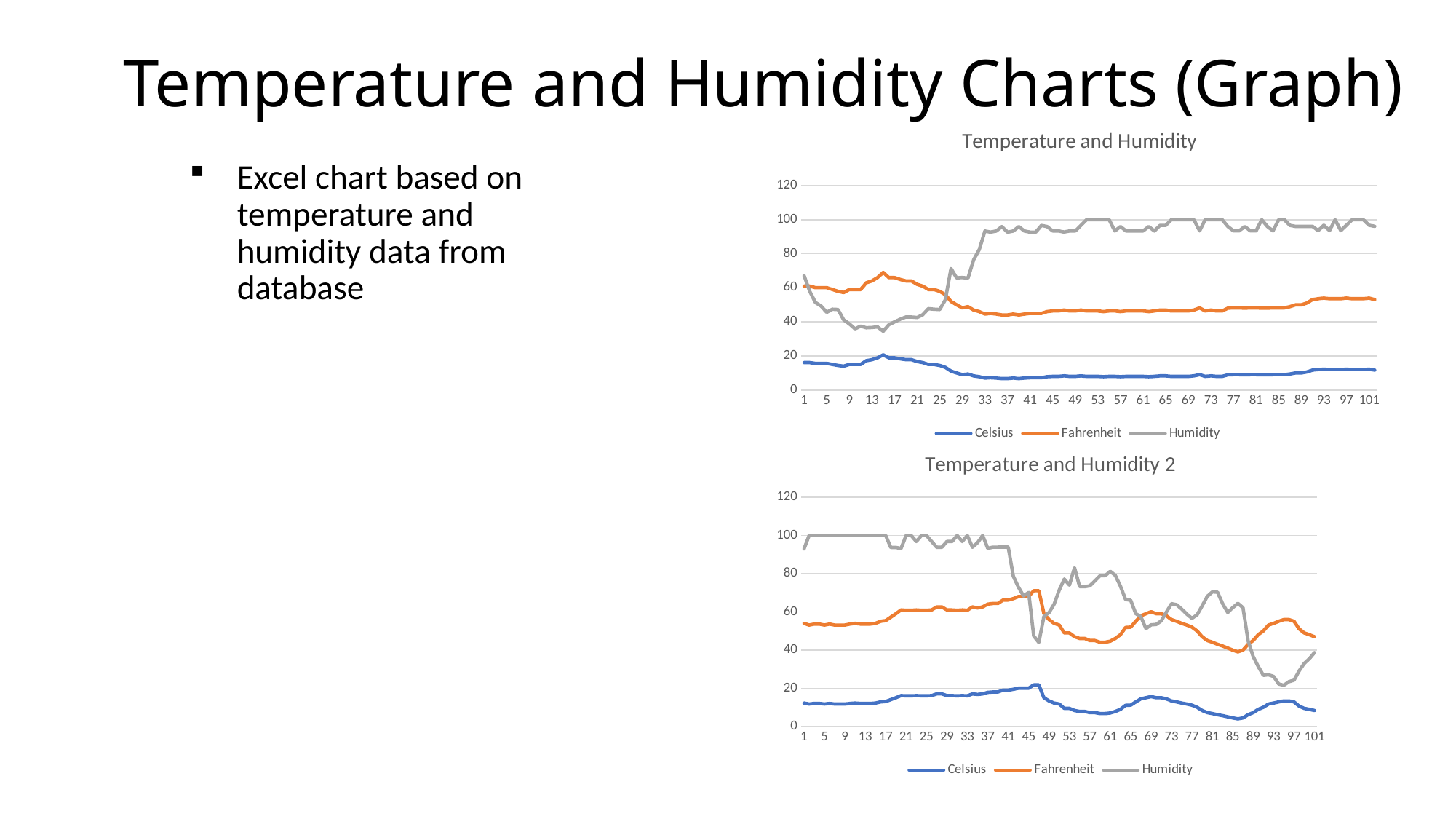
In the 'Temperature and Humidity' chart, is the Humidity value at point 101 greater or less than 80? greater In the 'Temperature and Humidity 2' chart, does the Humidity series overall rise or fall from point 1 to point 101? fall In the 'Temperature and Humidity 2' chart, which series has the larger value at point 1, Humidity or Fahrenheit? Humidity In the 'Temperature and Humidity' chart, is the Celsius value at point 101 greater or less than 20? less In the 'Temperature and Humidity' chart, which series has the larger value at point 13, Fahrenheit or Humidity? Fahrenheit In the 'Temperature and Humidity 2' chart, is the Humidity value at point 1 greater or less than 80? greater What is the title of the lower chart on the slide? Temperature and Humidity 2 In the 'Temperature and Humidity' chart, does the Humidity series overall rise or fall from point 1 to point 101? rise How many series does the legend of the 'Temperature and Humidity 2' chart list? 3 What kind of chart is the 'Temperature and Humidity' chart at the top? line chart What are the series names in the legend of the 'Temperature and Humidity' chart? Celsius, Fahrenheit, Humidity